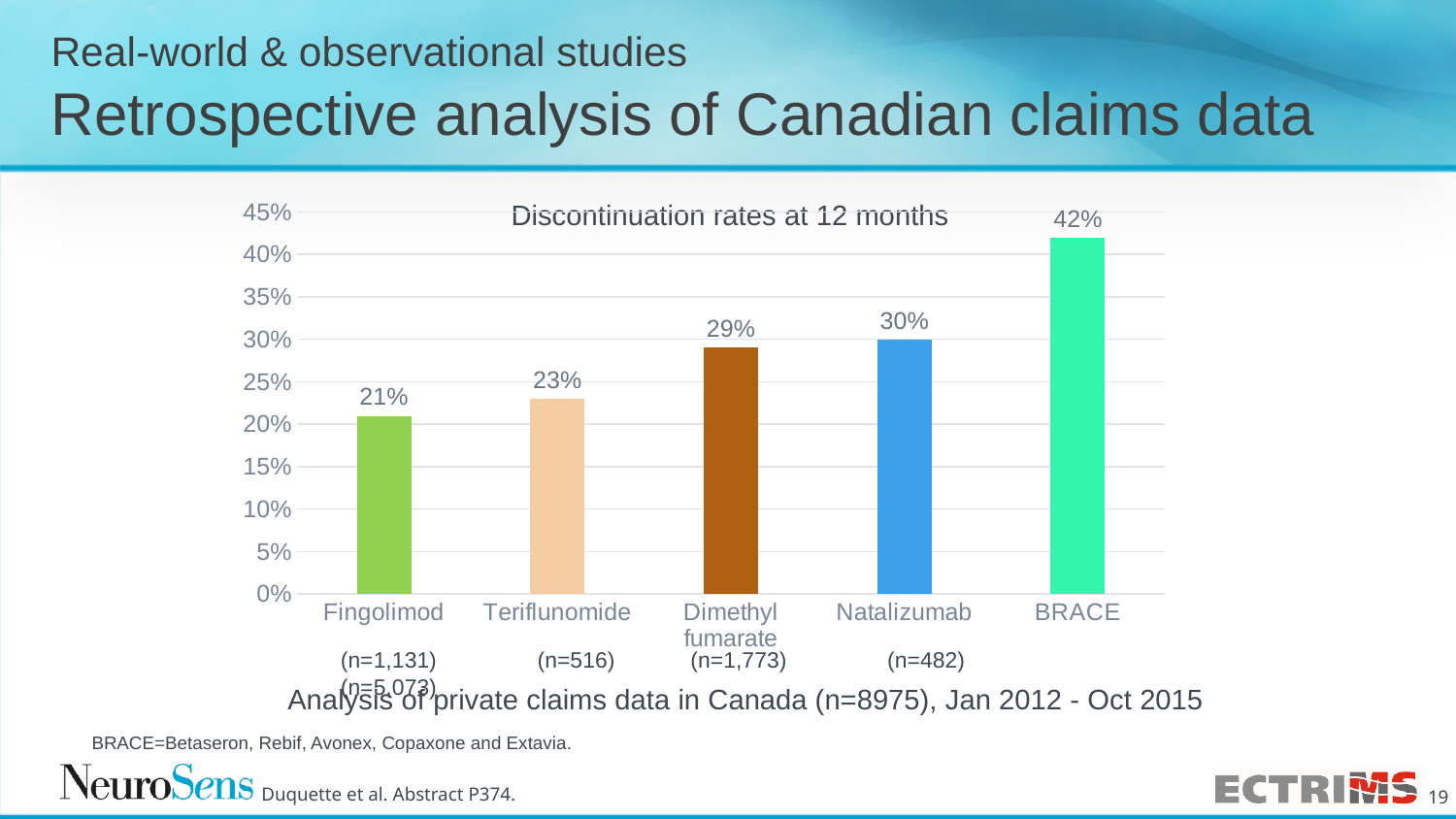
Do the discontinuation rates rise or fall moving from left to right across the categories? Rise What is the discontinuation rate at 12 months for Dimethyl fumarate? 29% What is the discontinuation rate at 12 months for Natalizumab? 30% Which treatment has the lowest discontinuation rate at 12 months? Fingolimod What is the title of the chart? Discontinuation rates at 12 months Which has a higher discontinuation rate, Dimethyl fumarate or Teriflunomide? Dimethyl fumarate How many treatment categories are shown in the chart? 5 What is the discontinuation rate at 12 months for Teriflunomide? 23% What type of chart is used to show the discontinuation rates? Bar chart What is the difference in discontinuation rate between BRACE and Fingolimod? 21% Which treatment has the highest discontinuation rate at 12 months? BRACE What is the discontinuation rate at 12 months for Fingolimod? 21%